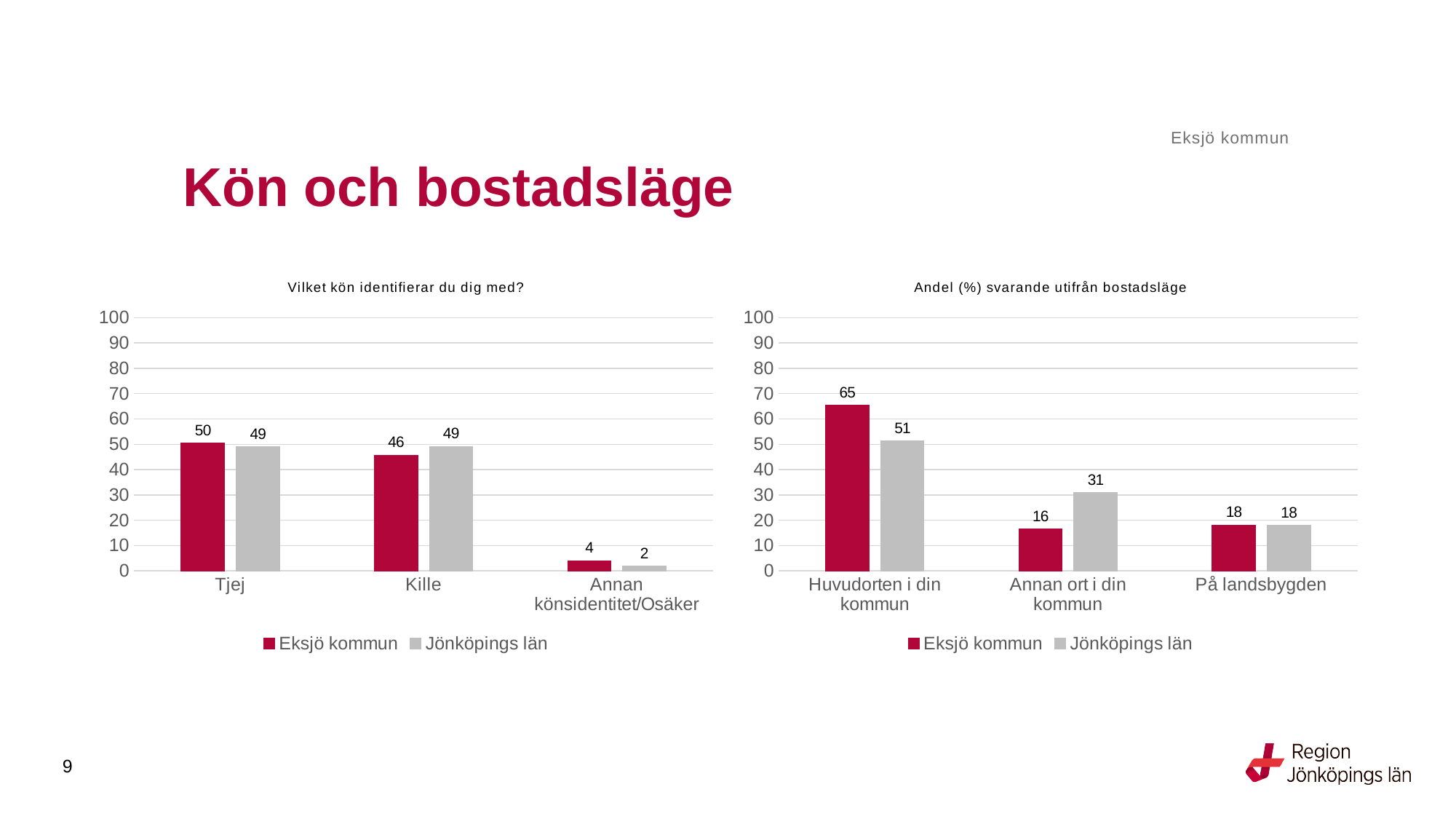
In the chart 'Vilket kön identifierar du dig med?', how many categories are shown on the x axis? 3 What kind of chart is 'Vilket kön identifierar du dig med?'? Bar chart In the chart 'Vilket kön identifierar du dig med?', what is the difference between Eksjö kommun and Jönköpings län for Kille? 3 In the chart 'Andel (%) svarande utifrån bostadsläge', which category has the highest value for Jönköpings län? Huvudorten i din kommun In the chart 'Vilket kön identifierar du dig med?', what is the value for Eksjö kommun for Tjej? 50 In the chart 'Andel (%) svarande utifrån bostadsläge', what is the value for Eksjö kommun for Huvudorten i din kommun? 65 In the chart 'Vilket kön identifierar du dig med?', which category has the lowest value for Eksjö kommun? Annan könsidentitet/Osäker In the chart 'Vilket kön identifierar du dig med?', what is the value for Jönköpings län for Kille? 49 How many series does the legend of the chart 'Andel (%) svarande utifrån bostadsläge' list? 2 In the chart 'Andel (%) svarande utifrån bostadsläge', what is the difference between Eksjö kommun and Jönköpings län for Huvudorten i din kommun? 14 In the chart 'Andel (%) svarande utifrån bostadsläge', what is the value for Jönköpings län for Annan ort i din kommun? 31 In the chart 'Andel (%) svarande utifrån bostadsläge', which is larger for Annan ort i din kommun: Eksjö kommun or Jönköpings län? Jönköpings län